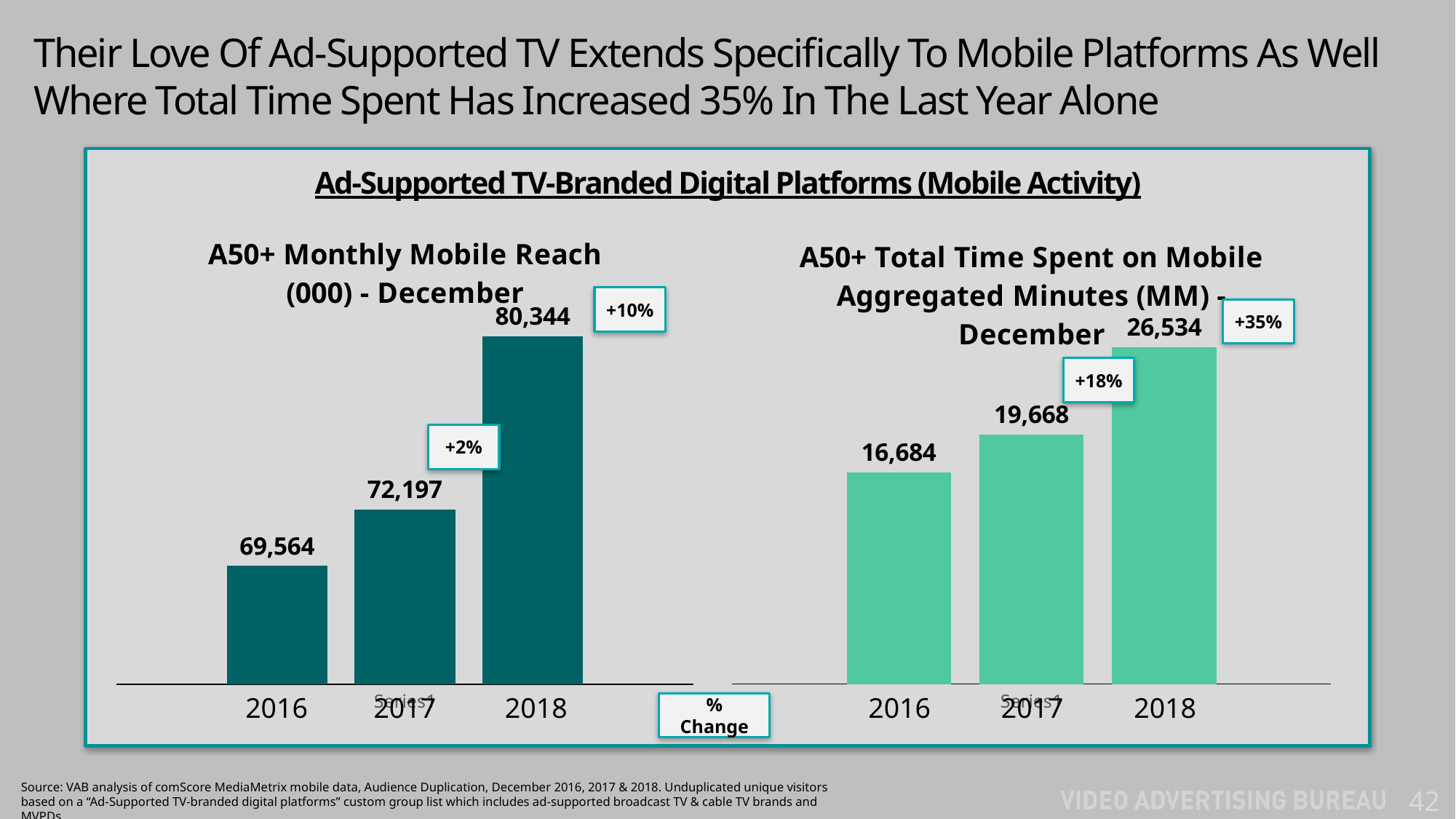
In the 'A50+ Total Time Spent on Mobile Aggregated Minutes (MM) - December' chart, what is the value for 2018? 26,534 In the 'A50+ Total Time Spent on Mobile Aggregated Minutes (MM) - December' chart, what is the difference between the 2018 and 2016 values? 9,850 How many years are plotted in the 'A50+ Total Time Spent on Mobile Aggregated Minutes (MM) - December' chart? 3 What type of chart is the 'A50+ Monthly Mobile Reach (000) - December' chart? bar chart In the 'A50+ Total Time Spent on Mobile Aggregated Minutes (MM) - December' chart, what percentage change is shown between 2017 and 2018? +35% In the 'A50+ Total Time Spent on Mobile Aggregated Minutes (MM) - December' chart, which year has the lowest value? 2016 In the 'A50+ Monthly Mobile Reach (000) - December' chart, which year has the highest value? 2018 In the 'A50+ Monthly Mobile Reach (000) - December' chart, what is the value for 2016? 69,564 In the 'A50+ Total Time Spent on Mobile Aggregated Minutes (MM) - December' chart, what is the value for 2017? 19,668 In the 'A50+ Monthly Mobile Reach (000) - December' chart, is the value for 2017 larger or smaller than the value for 2016? larger In the 'A50+ Monthly Mobile Reach (000) - December' chart, what is the value for 2018? 80,344 In the 'A50+ Monthly Mobile Reach (000) - December' chart, what is the difference between the 2018 and 2017 values? 8,147